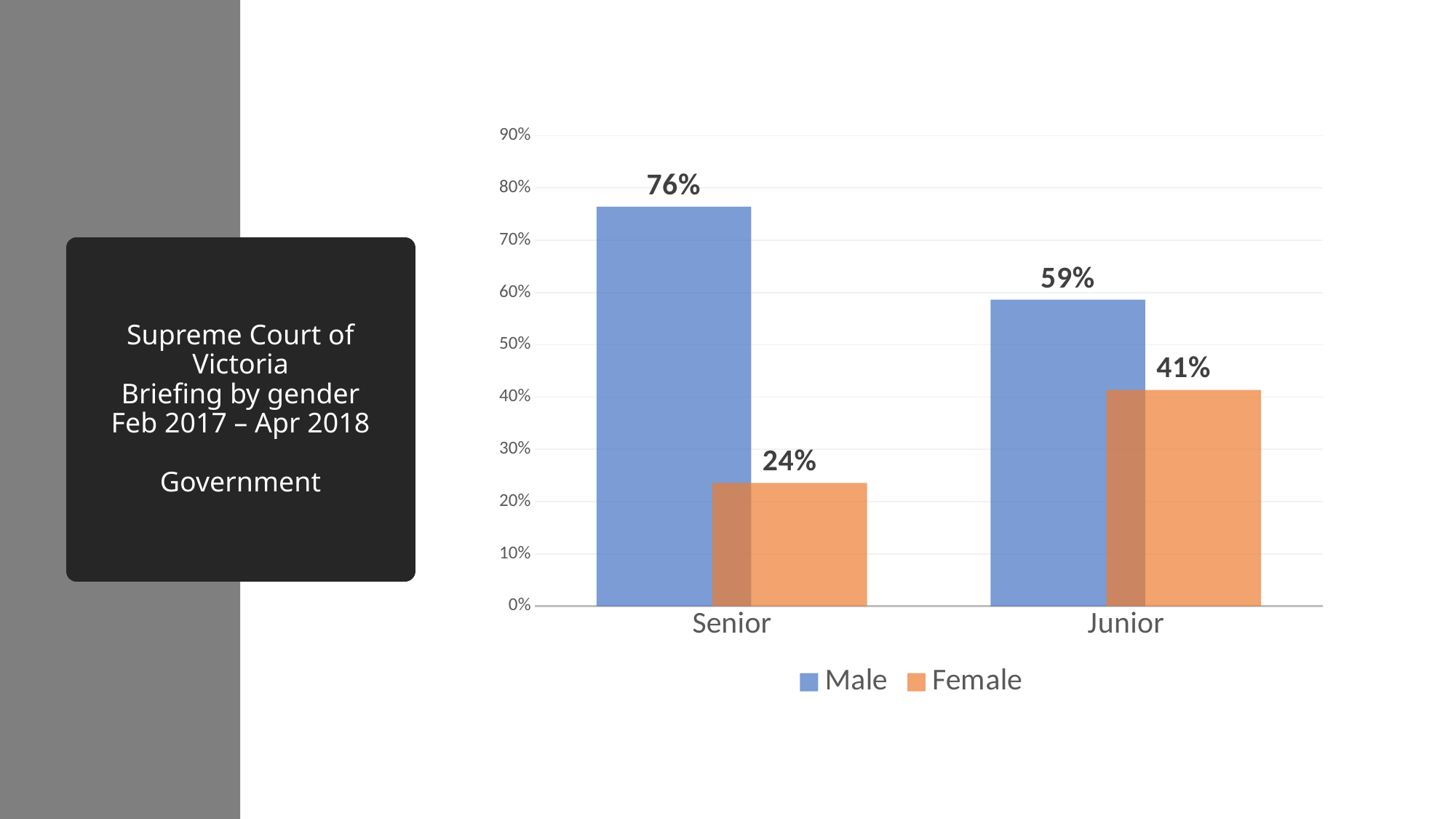
What is the difference between the Male values for Senior and Junior? 17% Which is larger, the Female value for Junior or the Female value for Senior? Junior What is the Male value for Senior? 76% How many categories are shown on the x axis? 2 What is the Female value for Junior? 41% Which category has the highest Male value? Senior What is the Male value for Junior? 59% Which category has the lowest Female value? Senior What kind of chart is shown on the slide? Bar chart What is the Female value for Senior? 24% What is the difference between the Male and Female values for Senior? 52% How many series does the legend list? 2